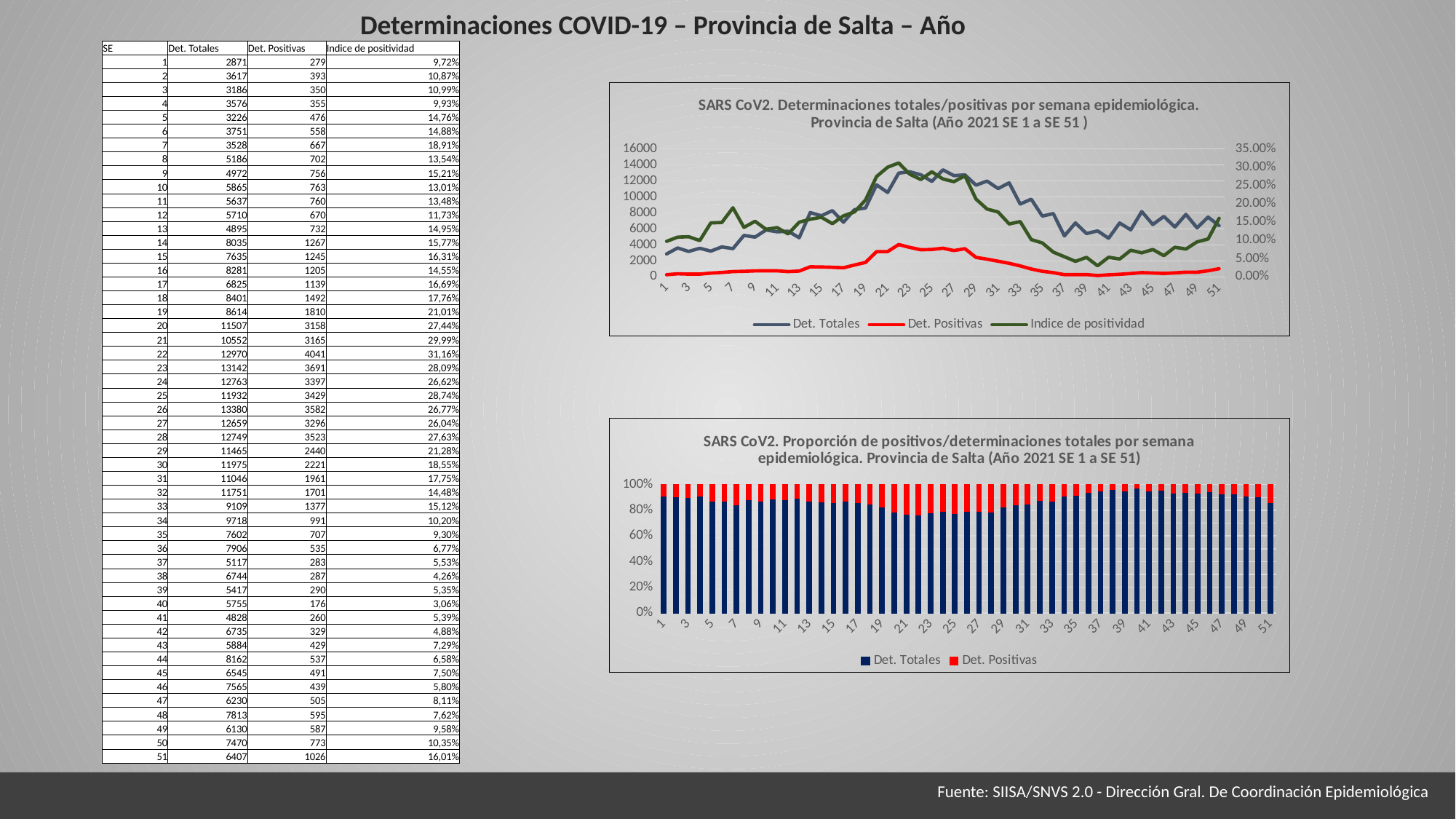
In the top chart, does Det. Totales rise or fall between week 1 and week 22? Rise In the top chart, what colour is the Det. Positivas line? Red What kind of chart is the bottom chart, 'SARS CoV2. Proporción de positivos/determinaciones totales por semana epidemiológica'? Bar chart In the top chart, does the Indice de positividad rise or fall between week 28 and week 40? Fall In the bottom chart, how many series does the legend list? 2 In the top chart, is Det. Totales larger at week 20 or at week 5? Week 20 In the top chart, is the value of Det. Totales at week 22 greater or less than 12000? greater In the top chart, how many epidemiological weeks are plotted along the x axis? 51 In the top chart, how many series does the legend list? 3 What kind of chart is the top chart, 'SARS CoV2. Determinaciones totales/positivas por semana epidemiológica'? Line chart In the top chart, is the value of Det. Totales at week 37 greater or less than 6000? less In the top chart, is the Indice de positividad at week 40 greater or less than 5.00%? less